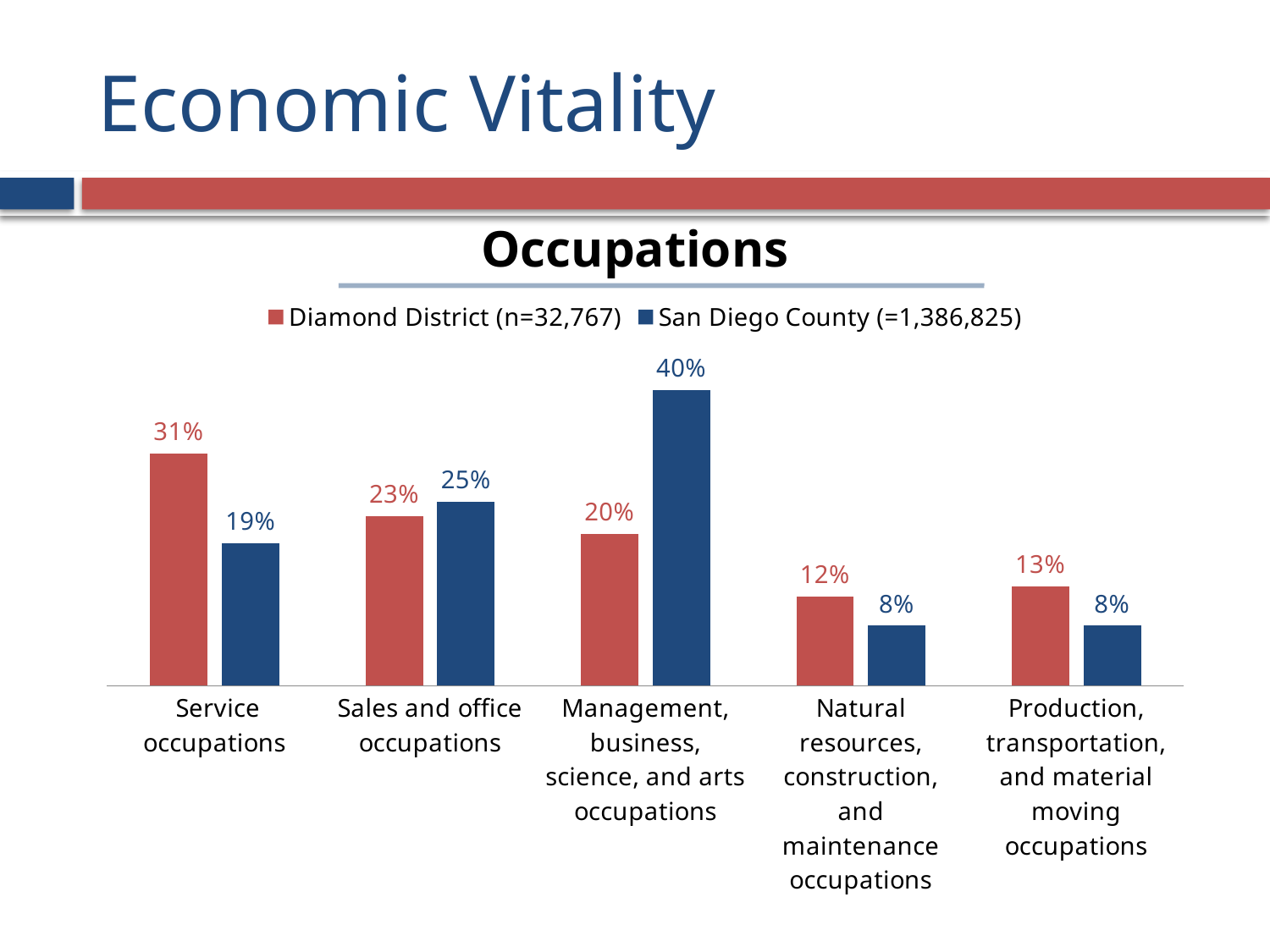
What kind of chart is shown on the slide? Bar chart Which occupation category has the lowest Diamond District value? Natural resources, construction, and maintenance occupations What is the difference between the Diamond District and San Diego County values for Service occupations? 12% What is the Diamond District value for Natural resources, construction, and maintenance occupations? 12% How many occupation categories are shown on the chart? 5 Which occupation category has the highest San Diego County value? Management, business, science, and arts occupations For Sales and office occupations, which is larger: the Diamond District value or the San Diego County value? San Diego County How many series does the legend list? 2 What is the Diamond District value for Service occupations? 31% What is the San Diego County value for Management, business, science, and arts occupations? 40% What is the difference between the San Diego County and Diamond District values for Management, business, science, and arts occupations? 20% What is the title of the chart? Occupations